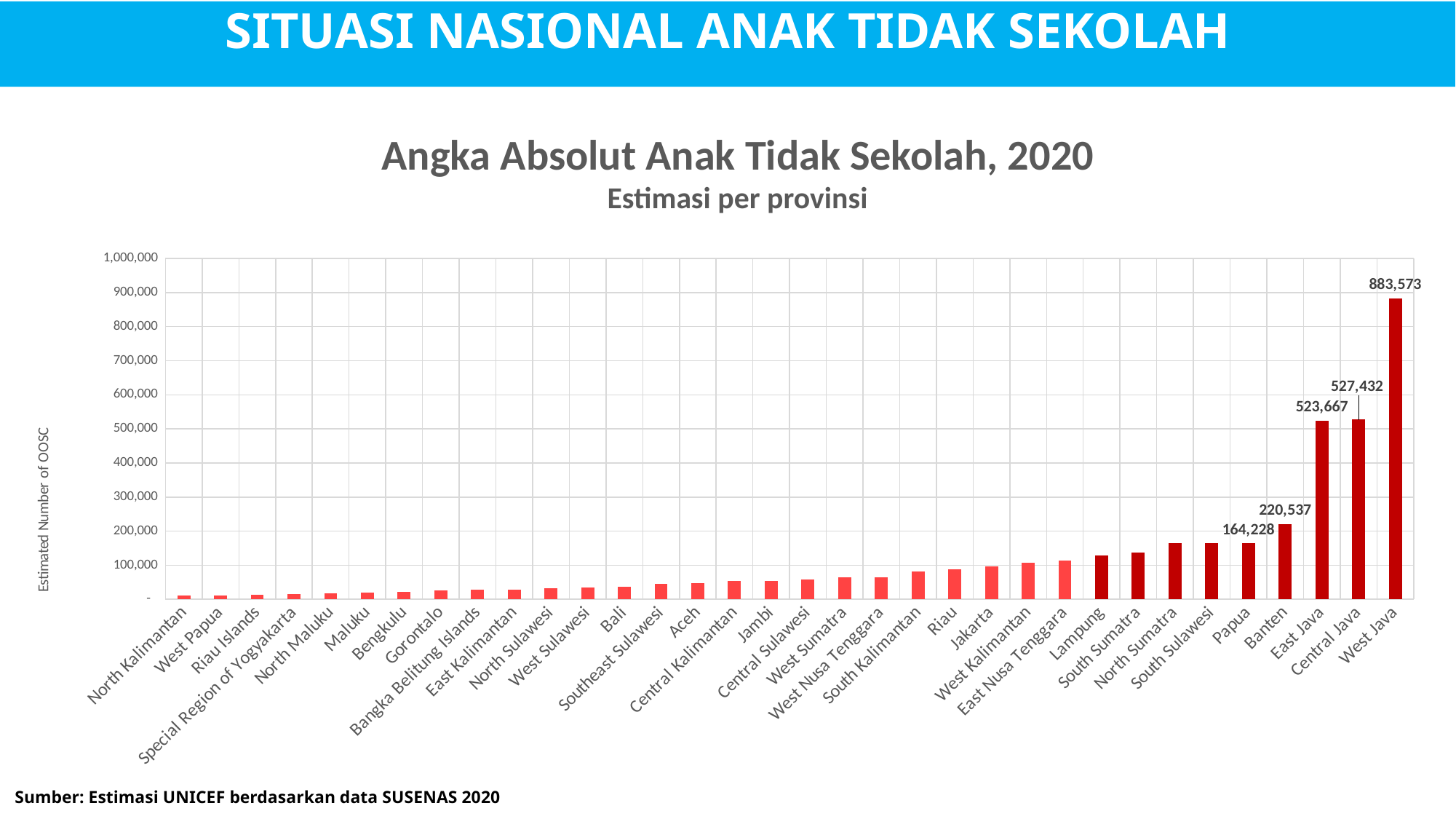
What is the value shown for Banten? 220,537 What is the value shown for Papua? 164,228 What is the difference between the values for Banten and Papua? 56,309 What is the value shown for Central Java? 527,432 How many provinces are shown on the x axis of the chart? 34 Which province has the highest value in the chart? West Java What is the difference between the values for West Java and Central Java? 356,141 Which has a larger value, Banten or Papua? Banten What is the estimated number of out-of-school children for West Java? 883,573 What type of chart is shown on the slide? bar chart Is the value for Lampung greater or less than 100,000? greater What is the value shown for East Java? 523,667